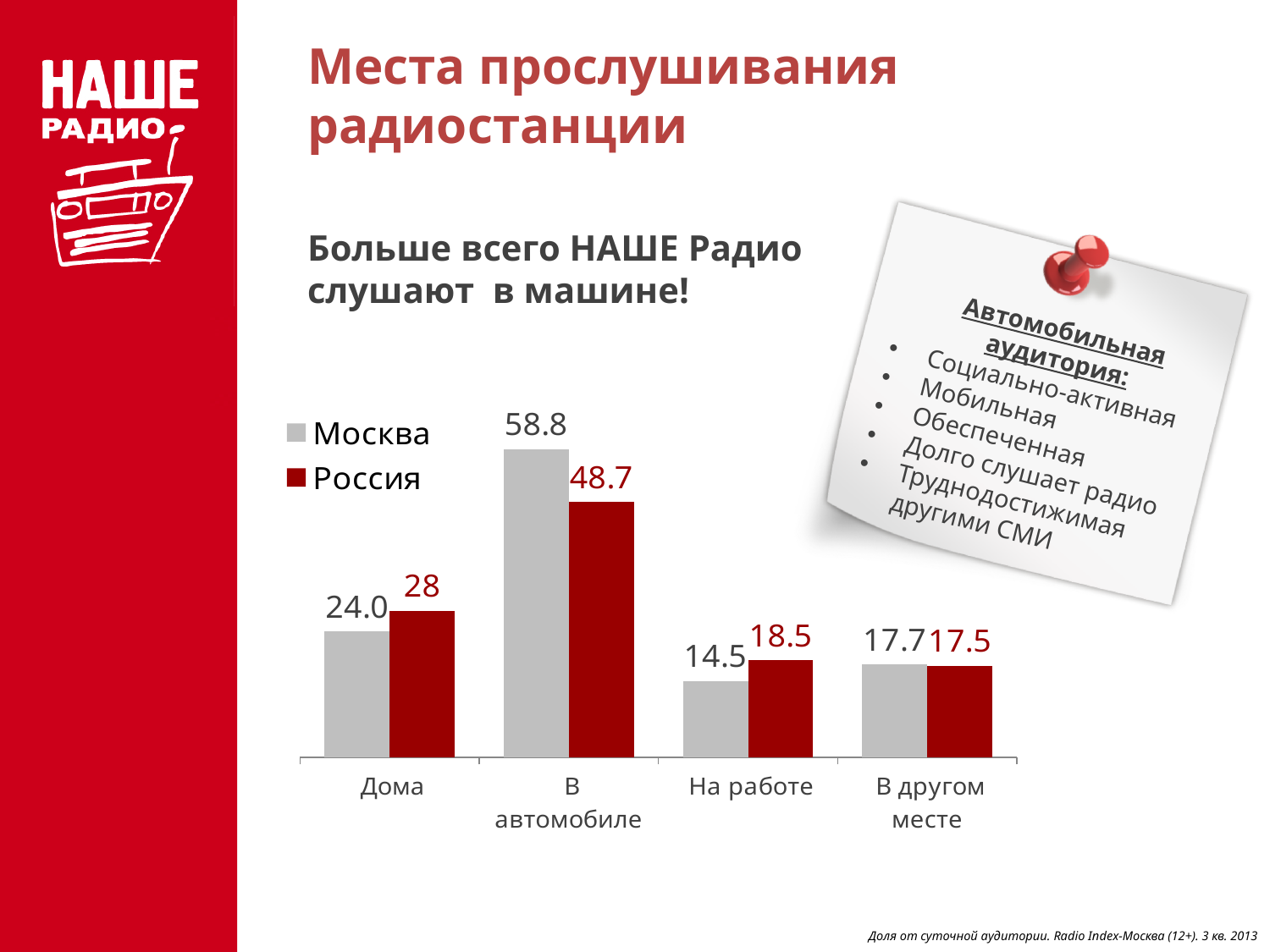
What is the value for Россия in the category В автомобиле? 48.7 How many categories are shown on the x axis of the chart? 4 Which category has the highest value for Москва? В автомобиле What is the value for Москва in the category Дома? 24.0 What is the difference between the Москва and Россия values in the category В автомобиле? 10.1 In the category На работе, which series has the larger value, Москва or Россия? Россия What is the value for Россия in the category В другом месте? 17.5 What kind of chart is shown on the slide? Bar chart How many series does the chart legend list? 2 What is the difference between the Россия and Москва values in the category Дома? 4 Which category has the lowest value for Россия? В другом месте What is the value for Москва in the category На работе? 14.5